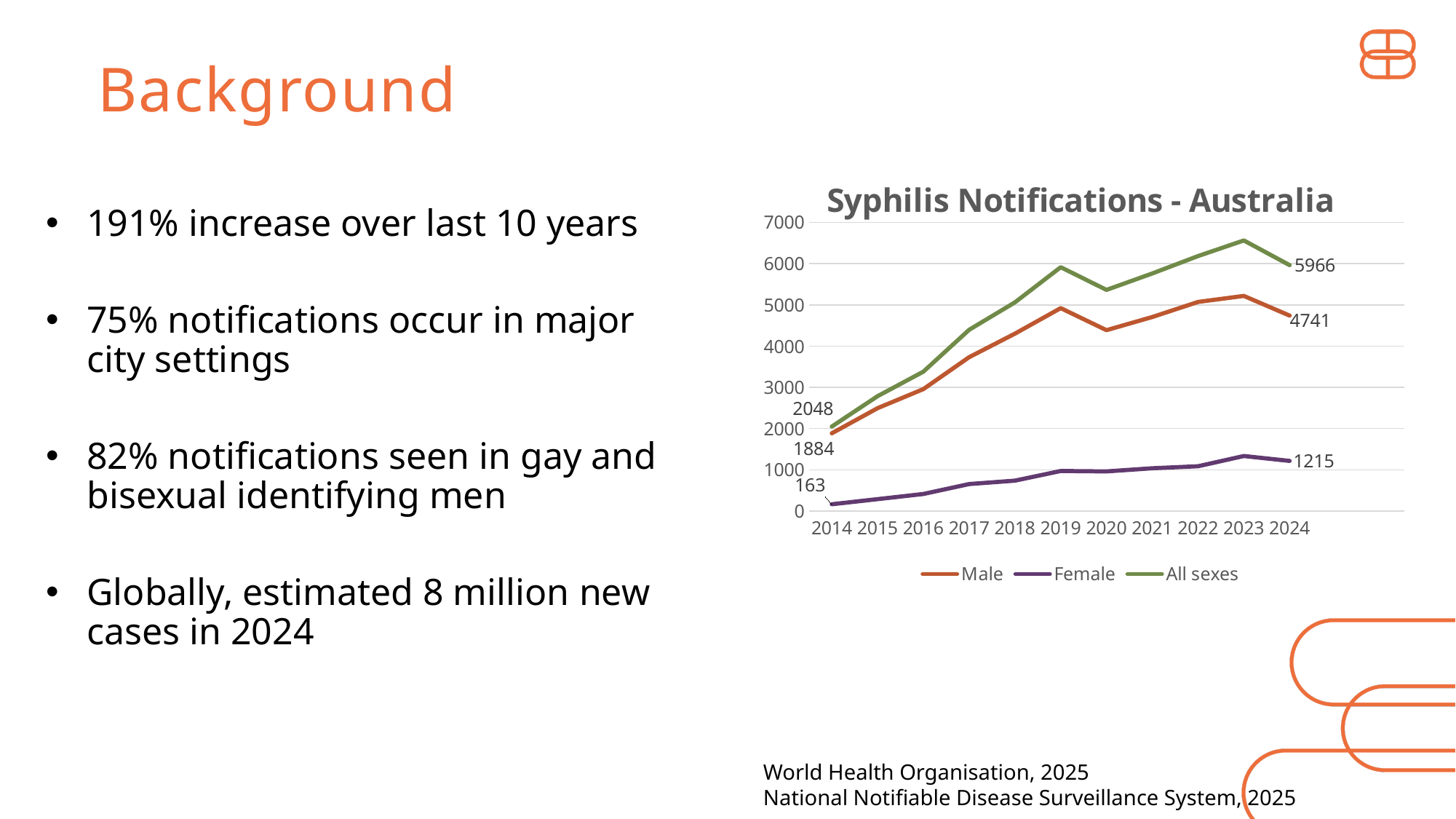
How many years are shown on the x axis? 11 Is the value for All sexes in 2023 greater or less than 6000? greater How many series does the legend of the chart list? 3 What is the title of the chart? Syphilis Notifications - Australia By how much did the All sexes value increase from 2014 to 2024? 3918 What kind of chart is shown on the slide? Line chart What is the value for All sexes in 2024? 5966 What is the difference between the Male and Female values in 2024? 3526 What is the value for Female in 2024? 1215 What is the value for Male in 2014? 1884 Which series has the highest value in 2024? All sexes What is the value for Female in 2014? 163